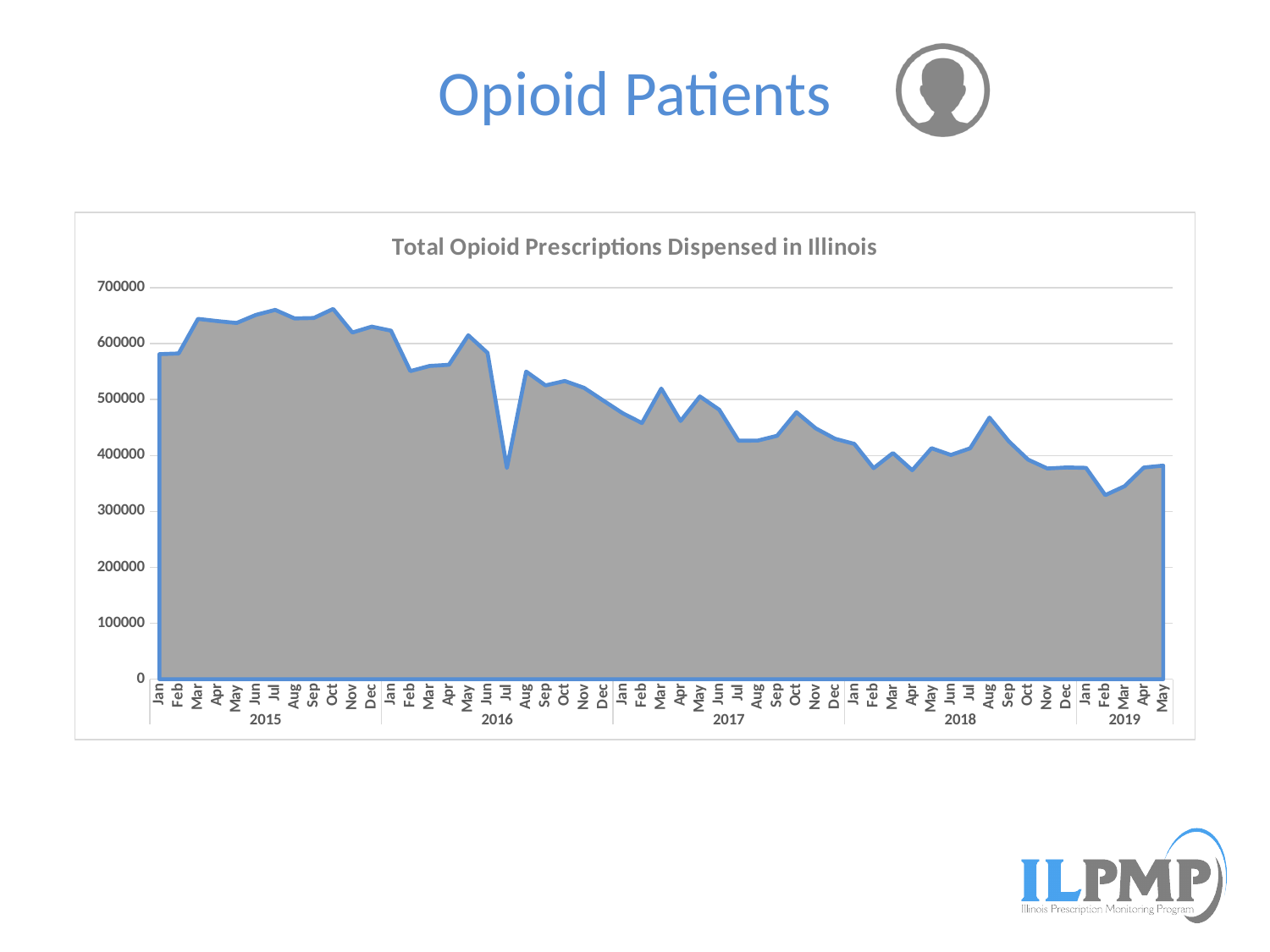
Is the value for Jul 2016 greater or less than 400000? less Is the value for Feb 2019 greater or less than 400000? less Which is larger, the value for Jun 2015 or the value for Jun 2018? Jun 2015 Is the value for Aug 2018 greater or less than 400000? greater Which years are shown along the x axis? 2015, 2016, 2017, 2018, 2019 Which month has the lowest value on the chart? Feb 2019 What is the title of the chart? Total Opioid Prescriptions Dispensed in Illinois What kind of chart is shown on the slide? area chart Overall, do the values rise or fall from 2015 to 2019? fall